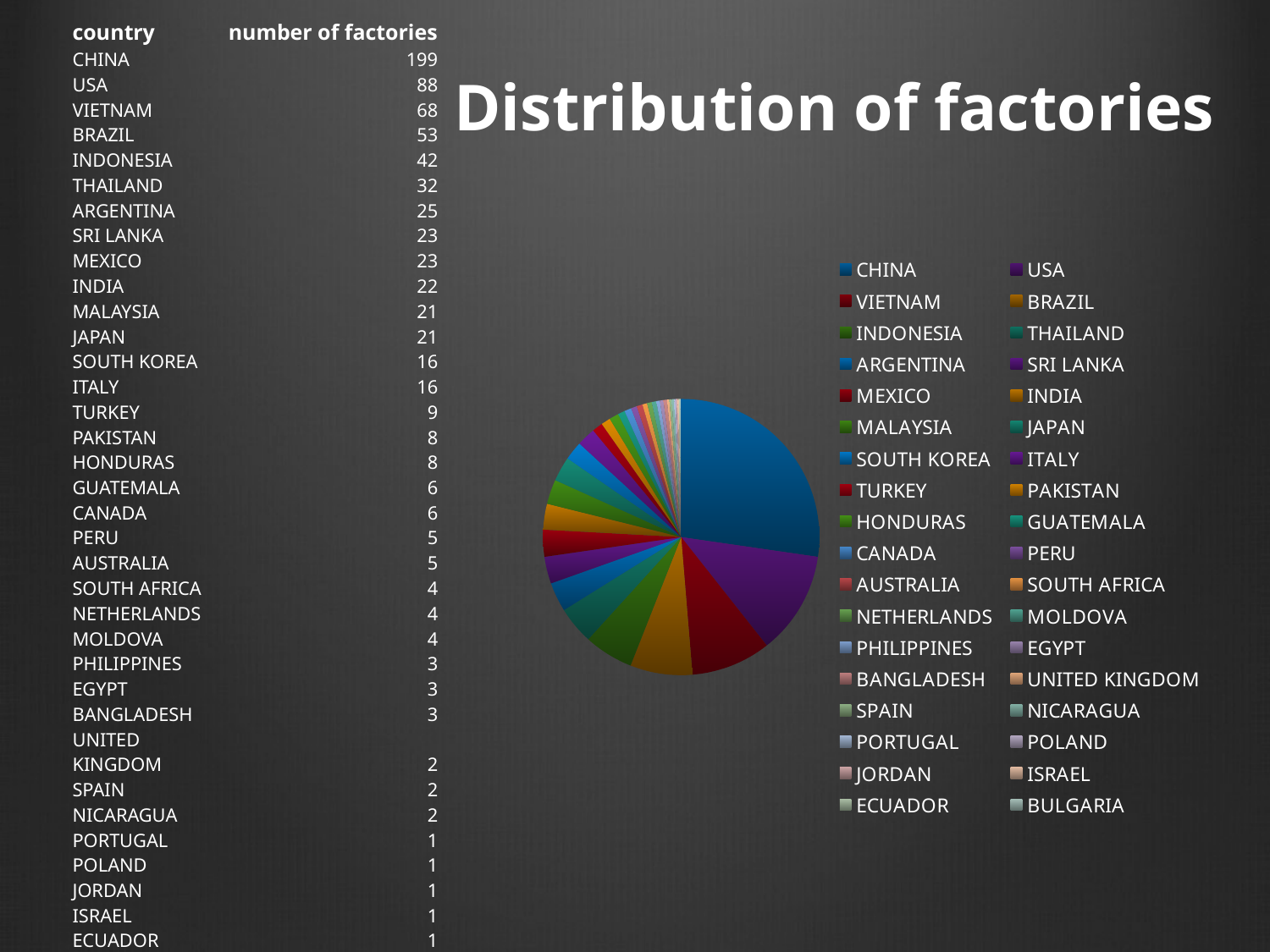
How many factories does Indonesia have? 42 Which country has the largest slice of the pie? CHINA Which has more factories, Argentina or India? Argentina Which has more factories, Brazil or Thailand? Brazil What is the difference in the number of factories between Vietnam and Brazil? 15 How many factories does Vietnam have? 68 How many factories does the USA have? 88 How many factories does China have according to the table? 199 What is the title of the chart? Distribution of factories What kind of chart is shown on the slide? pie chart How many countries are listed in the chart legend? 36 What is the difference in the number of factories between China and the USA? 111